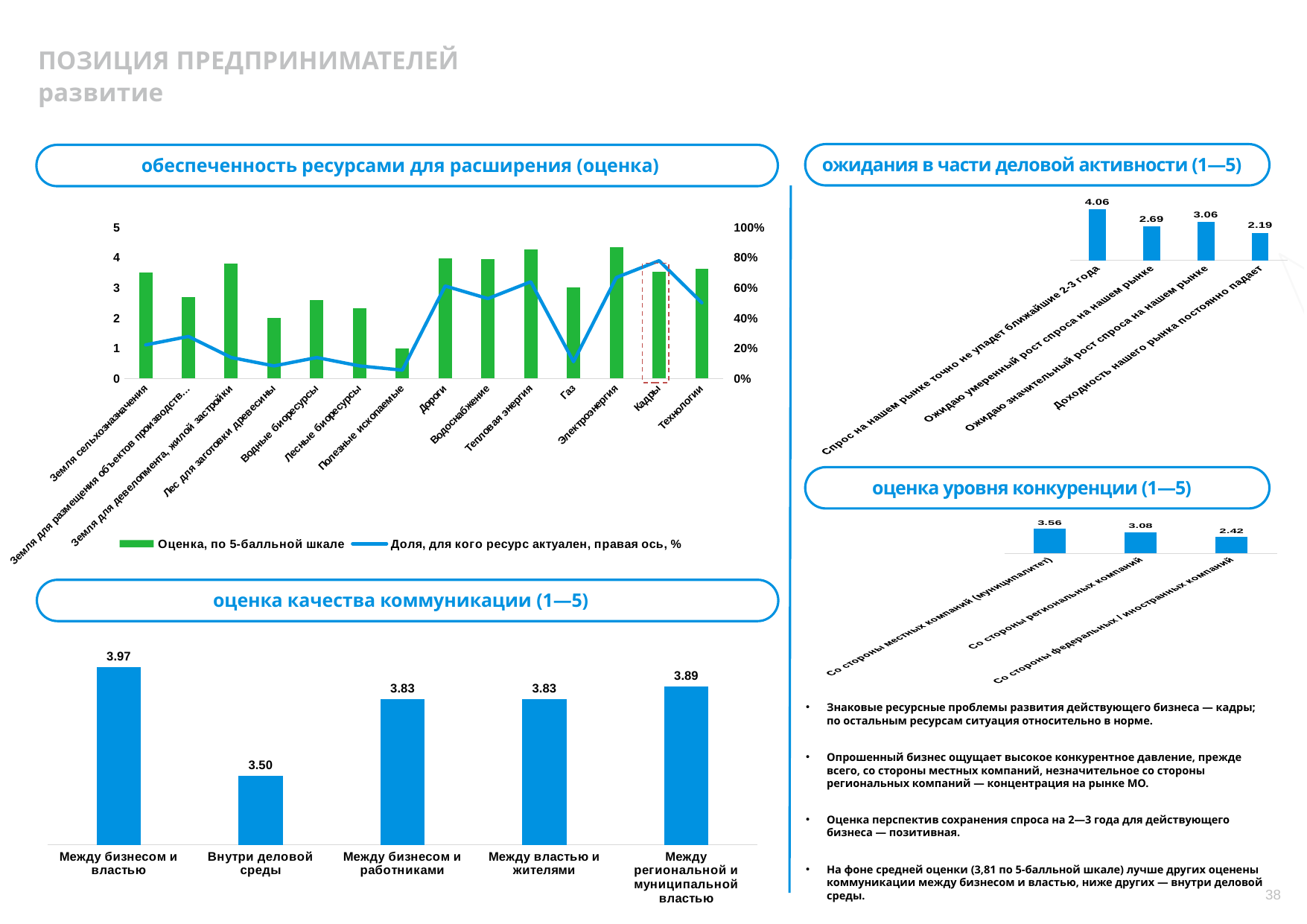
How many series does the legend list in the chart 'обеспеченность ресурсами для расширения (оценка)'? 2 In the chart 'оценка уровня конкуренции (1—5)', what is the value for 'Со стороны региональных компаний'? 3.08 In the chart 'обеспеченность ресурсами для расширения (оценка)', is the bar value for 'Полезные ископаемые' greater or less than 2? less In the chart 'оценка качества коммуникации (1—5)', which category has the highest value? Между бизнесом и властью In the chart 'ожидания в части деловой активности (1—5)', which category has the lowest value? Доходность нашего рынка постоянно падает What kind of chart is 'оценка качества коммуникации (1—5)'? bar chart How many categories are shown in the chart 'оценка качества коммуникации (1—5)'? 5 In the chart 'оценка уровня конкуренции (1—5)', what is the difference between 'Со стороны местных компаний (муниципалитет)' and 'Со стороны федеральных / иностранных компаний'? 1.14 In the chart 'оценка качества коммуникации (1—5)', what is the difference between 'Между бизнесом и властью' and 'Внутри деловой среды'? 0.47 In the chart 'оценка качества коммуникации (1—5)', what is the value for 'Внутри деловой среды'? 3.50 In the chart 'ожидания в части деловой активности (1—5)', which is larger: 'Ожидаю умеренный рост спроса на нашем рынке' or 'Ожидаю значительный рост спроса на нашем рынке'? Ожидаю значительный рост спроса на нашем рынке In the chart 'ожидания в части деловой активности (1—5)', what is the value for 'Спрос на нашем рынке точно не упадет ближайшие 2-3 года'? 4.06